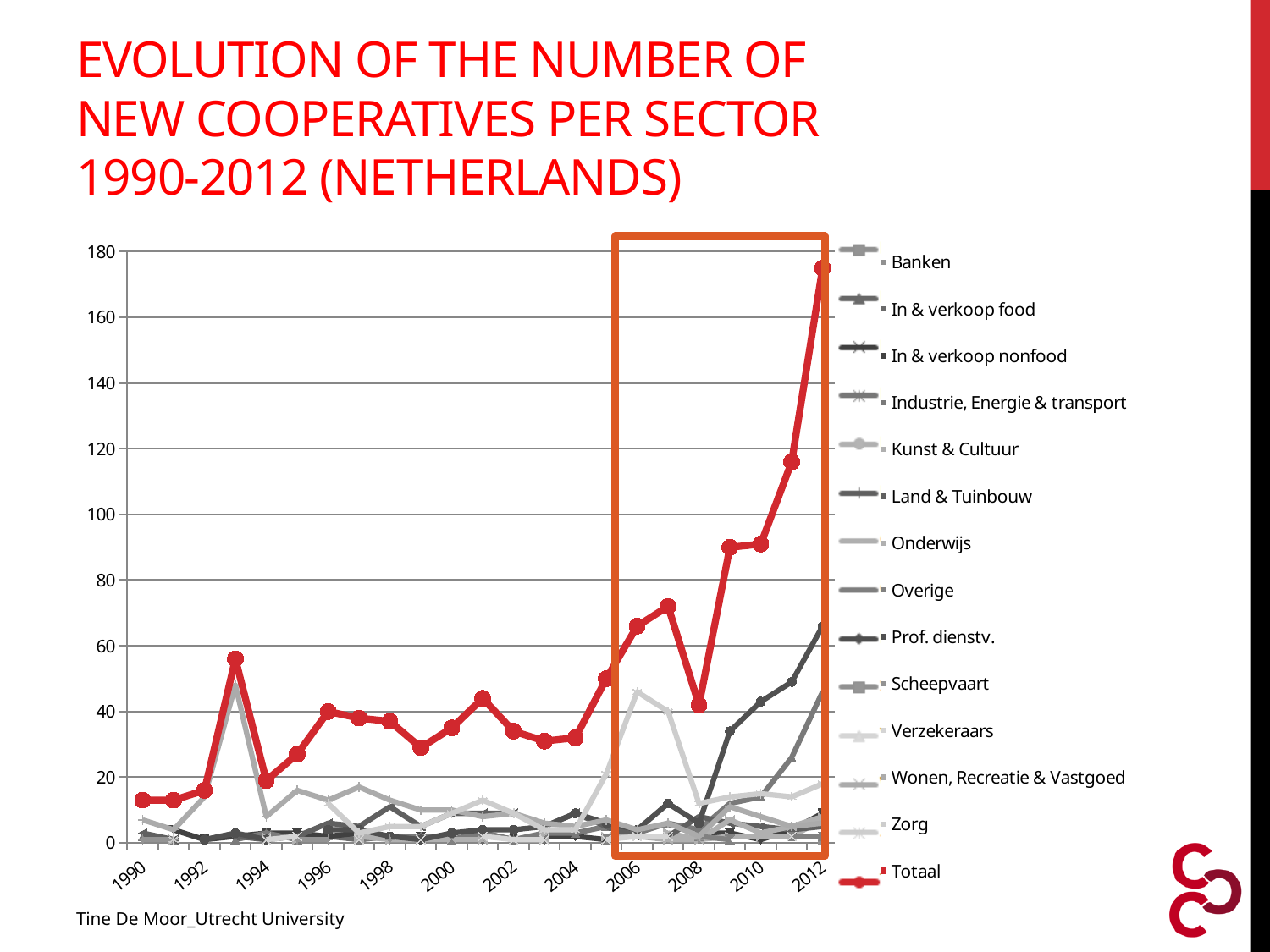
Is the Totaal value for 2012 greater or less than 160? greater What kind of chart is shown on the slide? line chart How many year labels are shown on the x axis? 12 Is the Totaal value for 1990 greater or less than 20? less Which is larger, the Totaal value for 2012 or for 2006? 2012 Is the Totaal value for 2011 greater or less than 100? greater Which series is drawn in red? Totaal How many series does the legend list? 14 Does the Totaal series rise or fall between 2008 and 2012? rise In which year does the Totaal series reach its highest value? 2012